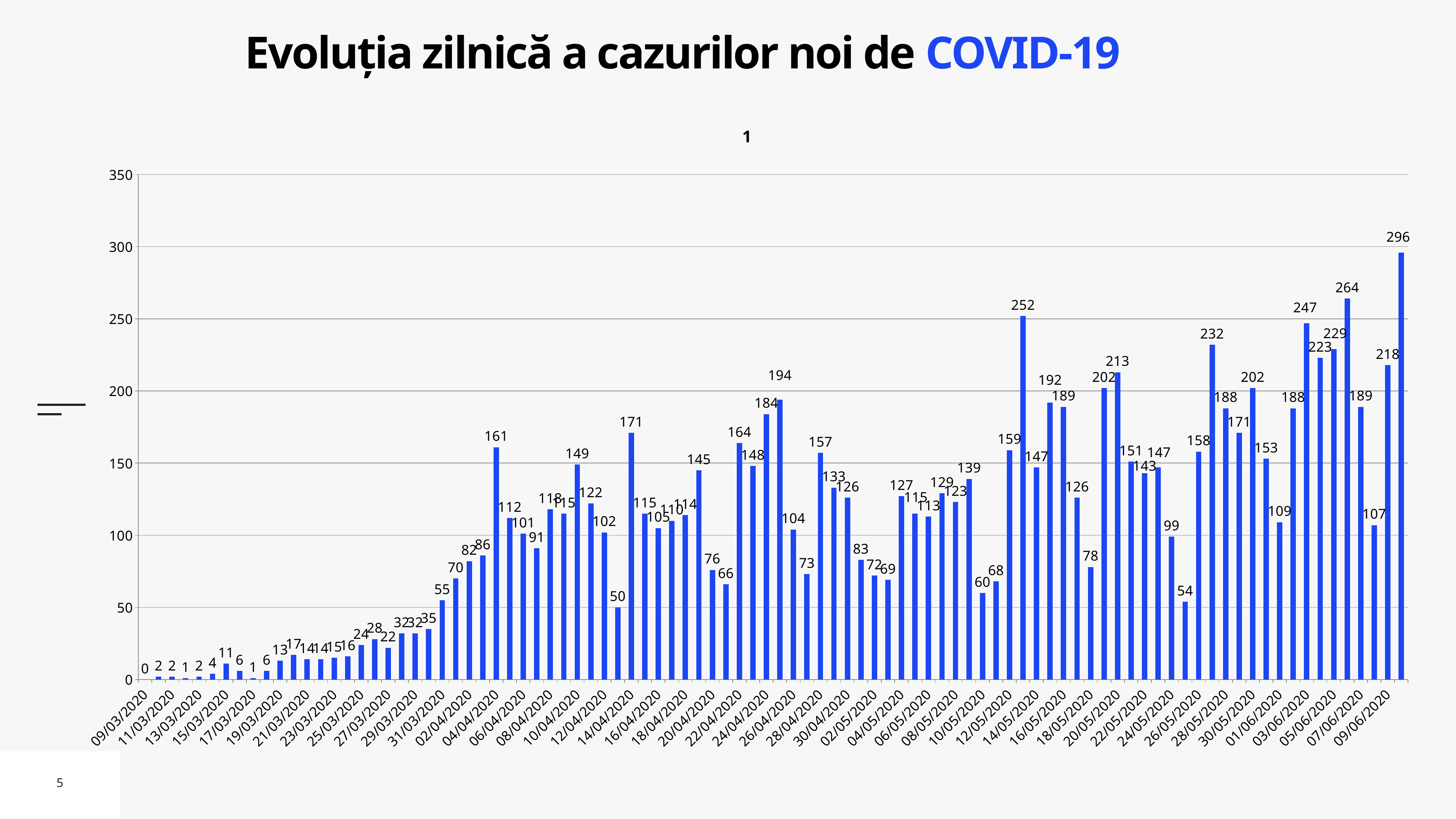
What is the value for 04/04/2020? 161 Overall, do the values rise or fall from left to right along the x axis? rise Is the value for 04/04/2020 greater or less than 150? greater What is the value for 13/05/2020? 252 What is the value for 12/05/2020? 159 What is the value for 14/04/2020? 171 Which is larger, the value for 13/05/2020 or the value for 12/05/2020? 13/05/2020 What is the highest daily value shown on the chart? 296 What is the value for 31/03/2020? 55 What is the difference between the values for 13/05/2020 and 12/05/2020? 93 What kind of chart is shown on the slide? bar chart What is the value for 09/03/2020? 0